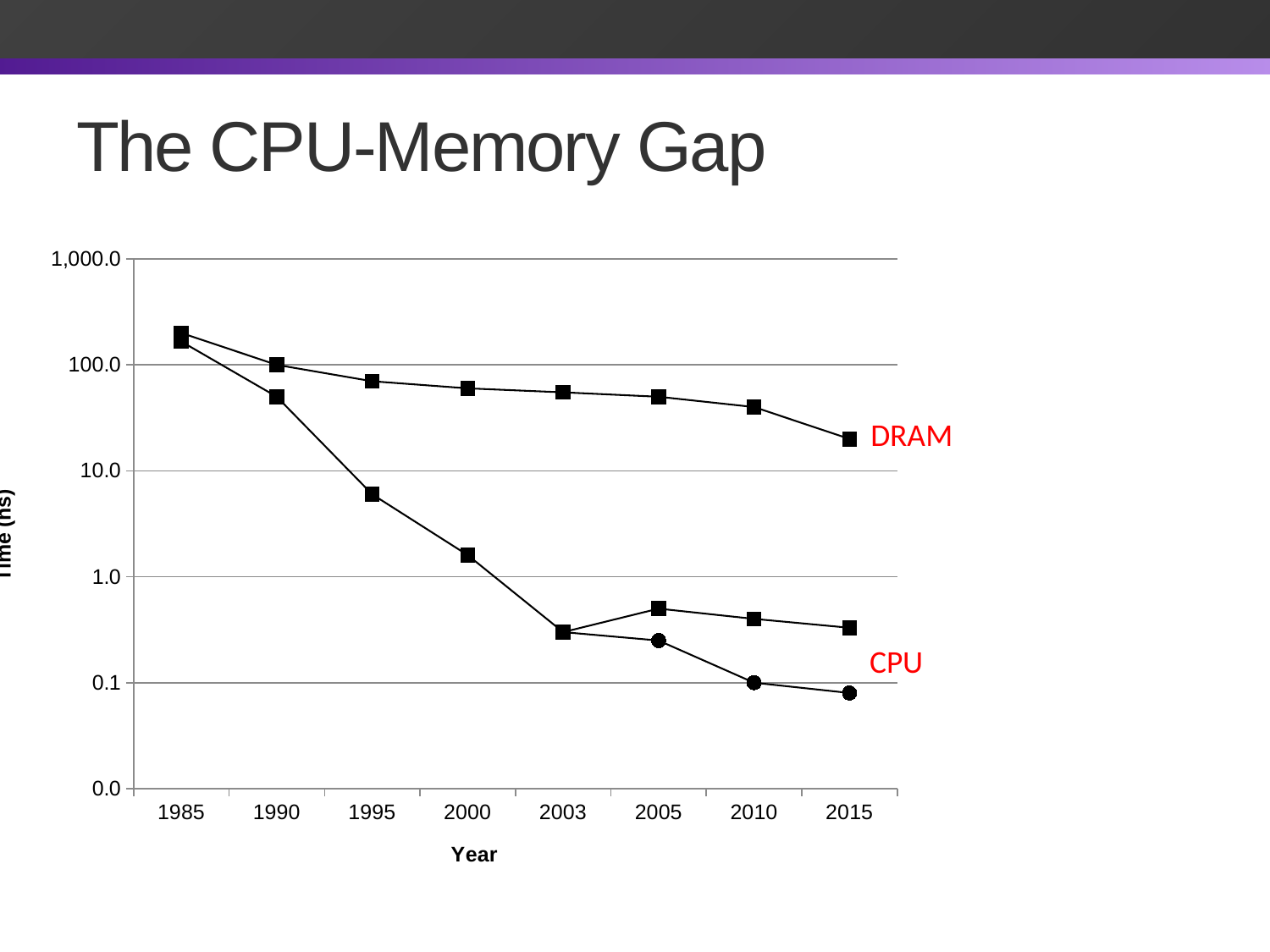
Is the DRAM value for 1985 greater or less than 100? greater Which year has the lowest DRAM value? 2015 What is the title of the chart? The CPU-Memory Gap Which year has the highest DRAM value? 1985 Is the DRAM value for 2015 greater or less than 10? greater How many years are marked along the x axis? 8 In 2015, which is larger, the DRAM value or the CPU value? DRAM What is the title of the x axis? Year Is the DRAM value for 2015 greater or less than 100? less What kind of chart is shown on the slide? line chart Do the DRAM values rise or fall from 1985 to 2015? fall